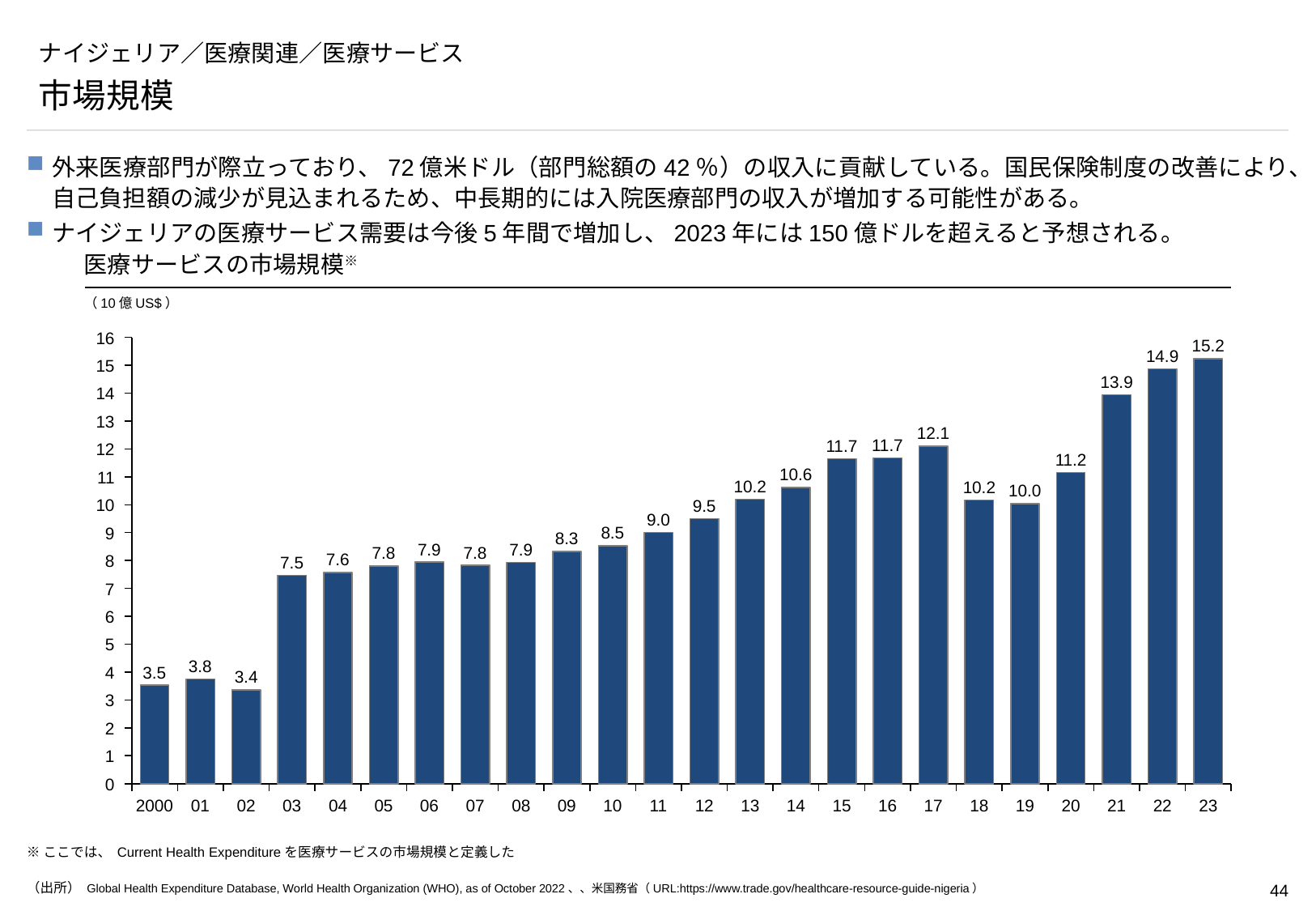
What unit is shown on the chart's axis label? 10 億 US$ What is the value for 2017 in the chart? 12.1 Which year has the highest value in the chart? 23 What kind of chart is shown on the slide? Bar chart What is the value for 2000 in the chart? 3.5 Which is larger, the value for 2014 or the value for 2020? 2020 Which year has the lowest value in the chart? 02 How many bars are plotted in the chart? 24 What is the difference between the values for 2017 and 2018? 1.9 What is the value for 2019 in the chart? 10.0 What is the value for 2023 in the 医療サービスの市場規模 chart? 15.2 What is the difference between the values for 2023 and 2000? 11.7